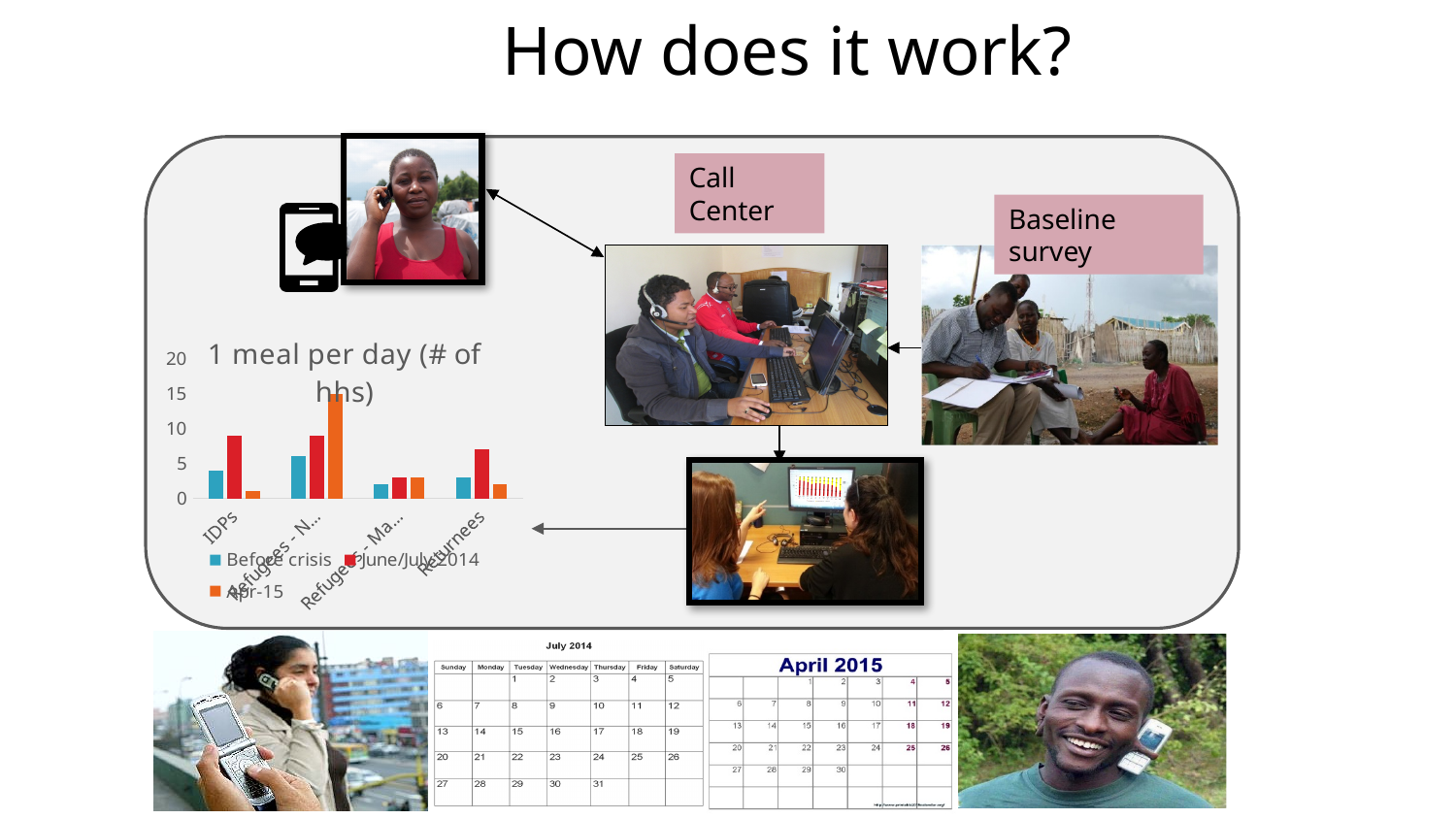
What is the title of the chart on the slide? 1 meal per day (# of hhs) For Returnees, which is larger: the Before crisis value or the June/July 2014 value? June/July 2014 Which series are listed in the chart's legend? Before crisis, June/July 2014, Apr-15 What kind of chart is shown on the slide? bar chart Is the Apr-15 value for the second category (Refugees - N...) greater or less than 10? greater Is the Before crisis value for Returnees greater or less than 5? less How many series does the chart's legend list? 3 Is the June/July 2014 value for IDPs greater or less than 5? greater Which series has the lowest value for the second category (Refugees - N...)? Before crisis Which series has the highest value for IDPs? June/July 2014 How many categories are shown on the x axis of the chart? 4